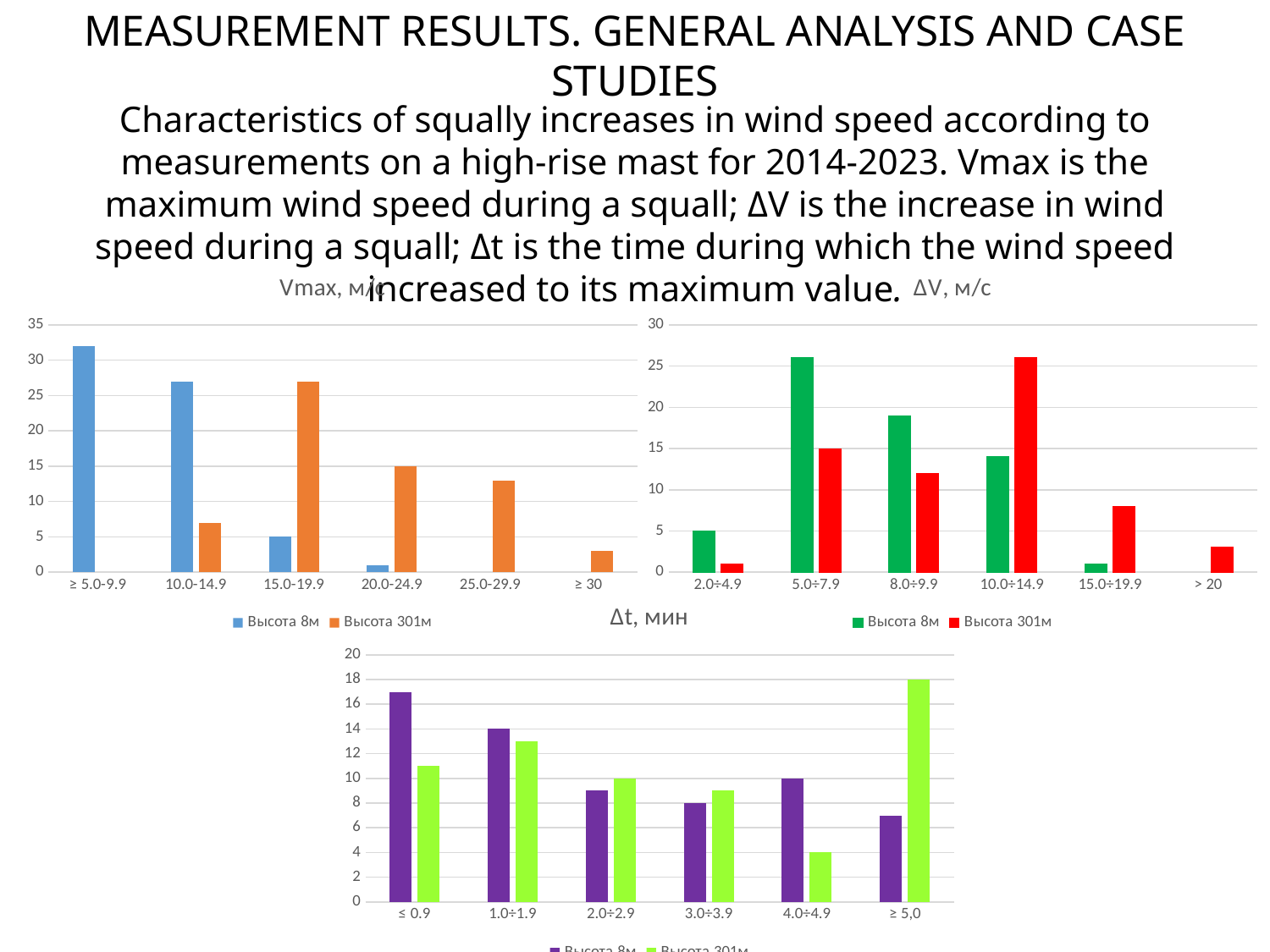
In the ΔV, м/с chart, which category has the highest value for Высота 301м? 10.0÷14.9 In the Vmax, м/с chart, how many categories are shown on the x axis? 6 In the Δt, мин chart, which category has the highest value for Высота 301м? ≥ 5,0 In the ΔV, м/с chart, is the value for Высота 8м at 8.0÷9.9 greater or less than 15? greater In the ΔV, м/с chart, which is larger at 15.0÷19.9: Высота 8м or Высота 301м? Высота 301м How many series does the legend of the ΔV, м/с chart list? 2 In the ΔV, м/с chart, which category has the highest value for Высота 8м? 5.0÷7.9 In the Δt, мин chart, is the value for Высота 8м at ≤ 0.9 greater or less than 16? greater In the Δt, мин chart, which category has the lowest value for Высота 301м? 4.0÷4.9 In the Vmax, м/с chart, is the value for Высота 8м at ≥ 5.0-9.9 greater or less than 30? greater